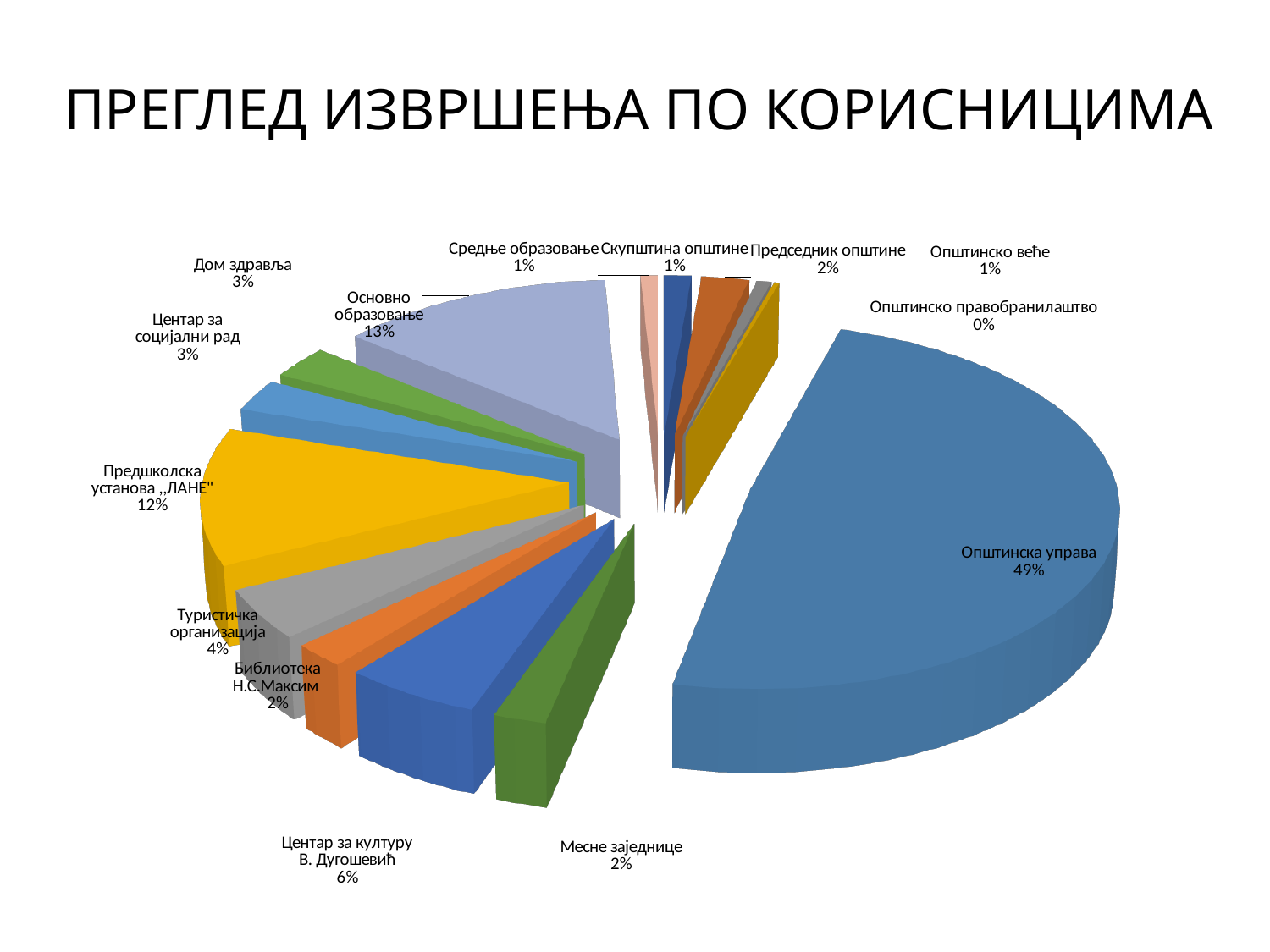
What is the value shown for Центар за културу В. Дугошевић? 6% Which has a larger share, Предшколска установа ,,ЛАНЕ" or Центар за културу В. Дугошевић? Предшколска установа ,,ЛАНЕ" What is the value shown for Основно образовање? 13% What is the value shown for Туристичка организација? 4% How many categories (slices) are shown in the pie chart? 14 Which category has the largest share of the pie? Општинска управа What share of the pie does Општинска управа have? 49% What kind of chart is shown on the slide? pie chart Which category has the smallest share of the pie? Општинско правобранилаштво What is the title of the chart slide? ПРЕГЛЕД ИЗВРШЕЊА ПО КОРИСНИЦИМА What is the difference between the shares of Општинска управа and Основно образовање? 36% What is the value shown for Предшколска установа ,,ЛАНЕ"? 12%